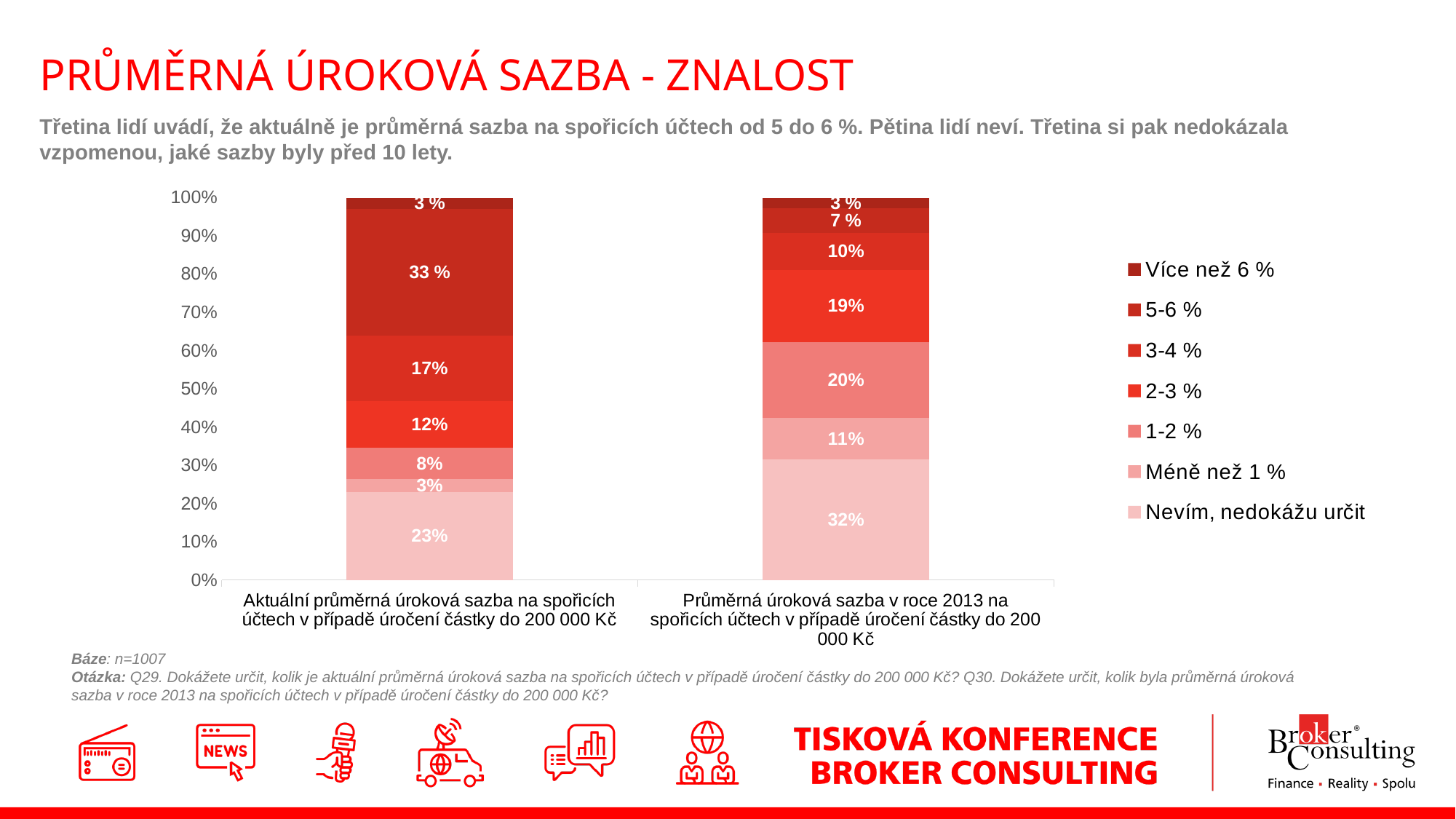
How many bars (categories) are plotted on the chart? 2 What is the value of the "Méně než 1 %" segment in the bar for the current average interest rate? 3% What is the difference between the "5-6 %" values for the current rate bar (33 %) and the 2013 bar (7 %)? 26 percentage points Which segment is the largest in the bar for the average interest rate in 2013? Nevím, nedokážu určit Which segment is the largest in the bar for the current average interest rate (Aktuální průměrná úroková sazba)? 5-6 % What is the value of the "1-2 %" segment in the bar for the average interest rate in 2013? 20% What is the value of the "3-4 %" segment in the bar for the average interest rate in 2013? 10% What is the value of the "5-6 %" segment in the bar for the current average interest rate (Aktuální průměrná úroková sazba)? 33 % What is the value of the "Nevím, nedokážu určit" segment in the bar for the average interest rate in 2013? 32% Which bar has the larger "Nevím, nedokážu určit" segment: the current rate bar or the 2013 bar? the 2013 bar How many series does the legend list? 7 What kind of chart is shown on the slide? stacked bar chart